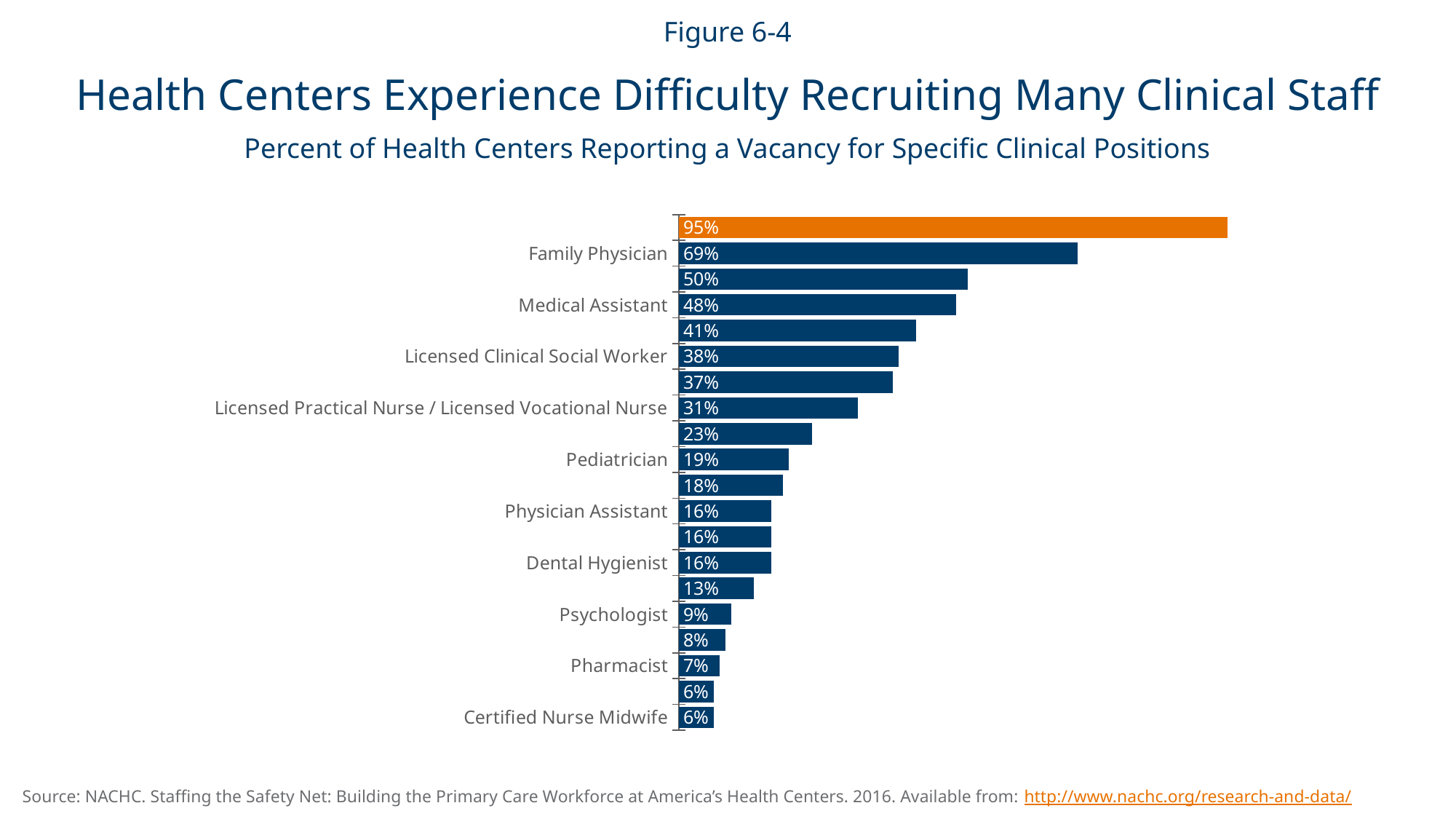
What is the value shown for Medical Assistant? 48% What is the value shown for Licensed Practical Nurse / Licensed Vocational Nurse? 31% What is the value shown for Pediatrician? 19% Which has a higher value, Psychologist or Pharmacist? Psychologist What percent of health centers reported a vacancy for Family Physician? 69% What is the highest value shown on the chart? 95% What is the difference between the values for Family Physician and Medical Assistant? 21 percentage points How many bars are plotted on the chart? 20 What kind of chart is shown on the slide? Bar chart What percent of health centers reported a vacancy for Licensed Clinical Social Worker? 38% What percent of health centers reported a vacancy for Pharmacist? 7% What colour is the topmost bar on the chart? Orange